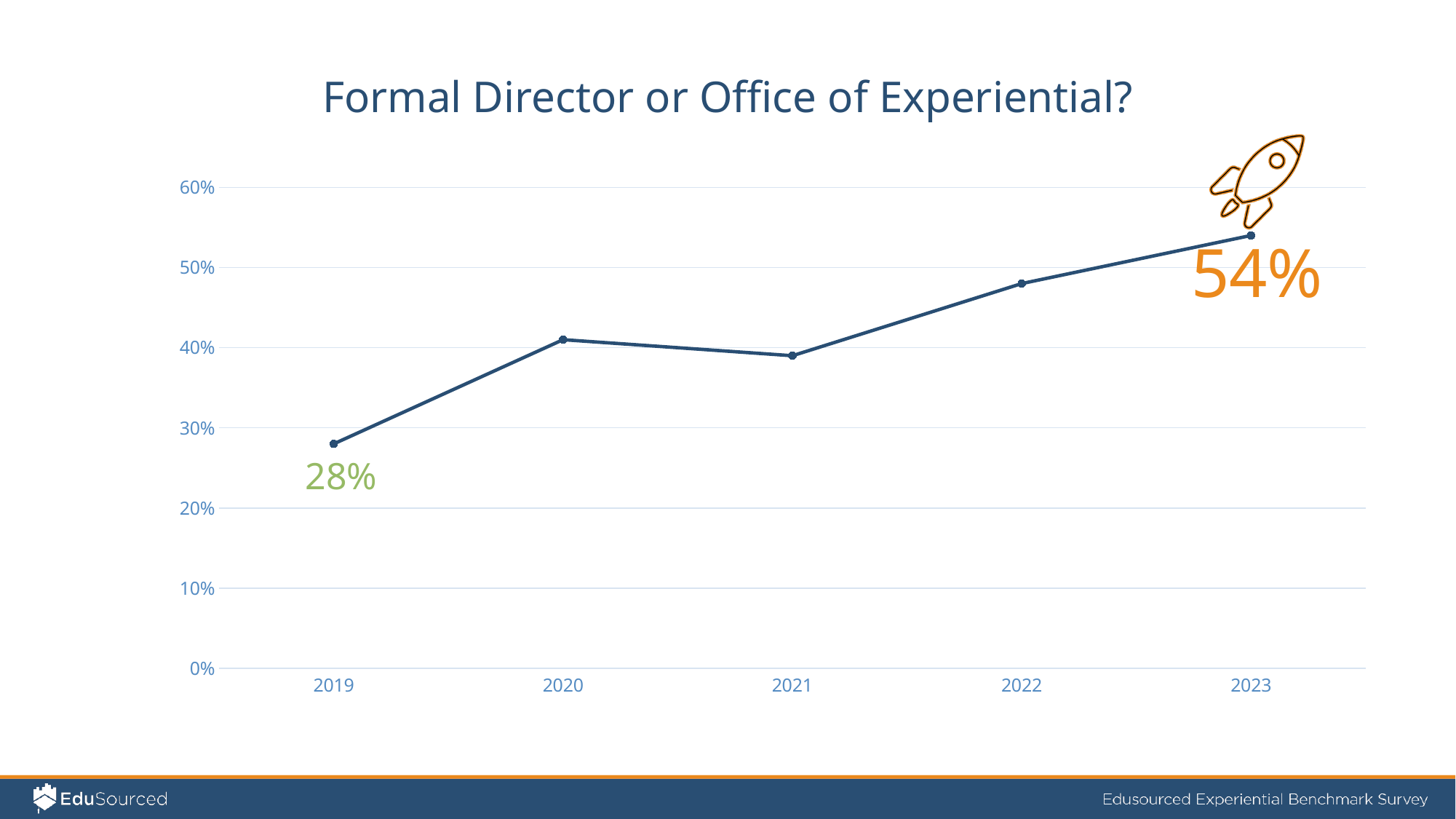
Is the value for 2020 greater or less than 50%? less What is the value for 2023? 54% Is the value for 2022 greater or less than 40%? greater Which year has the lowest value? 2019 Which is larger, the value for 2020 or the value for 2021? 2020 What kind of chart is shown? line chart Which year has the highest value? 2023 How many years are plotted on the x axis? 5 What is the title of the chart? Formal Director or Office of Experiential? What is the value for 2019? 28% What is the difference between the 2023 value and the 2019 value? 26%